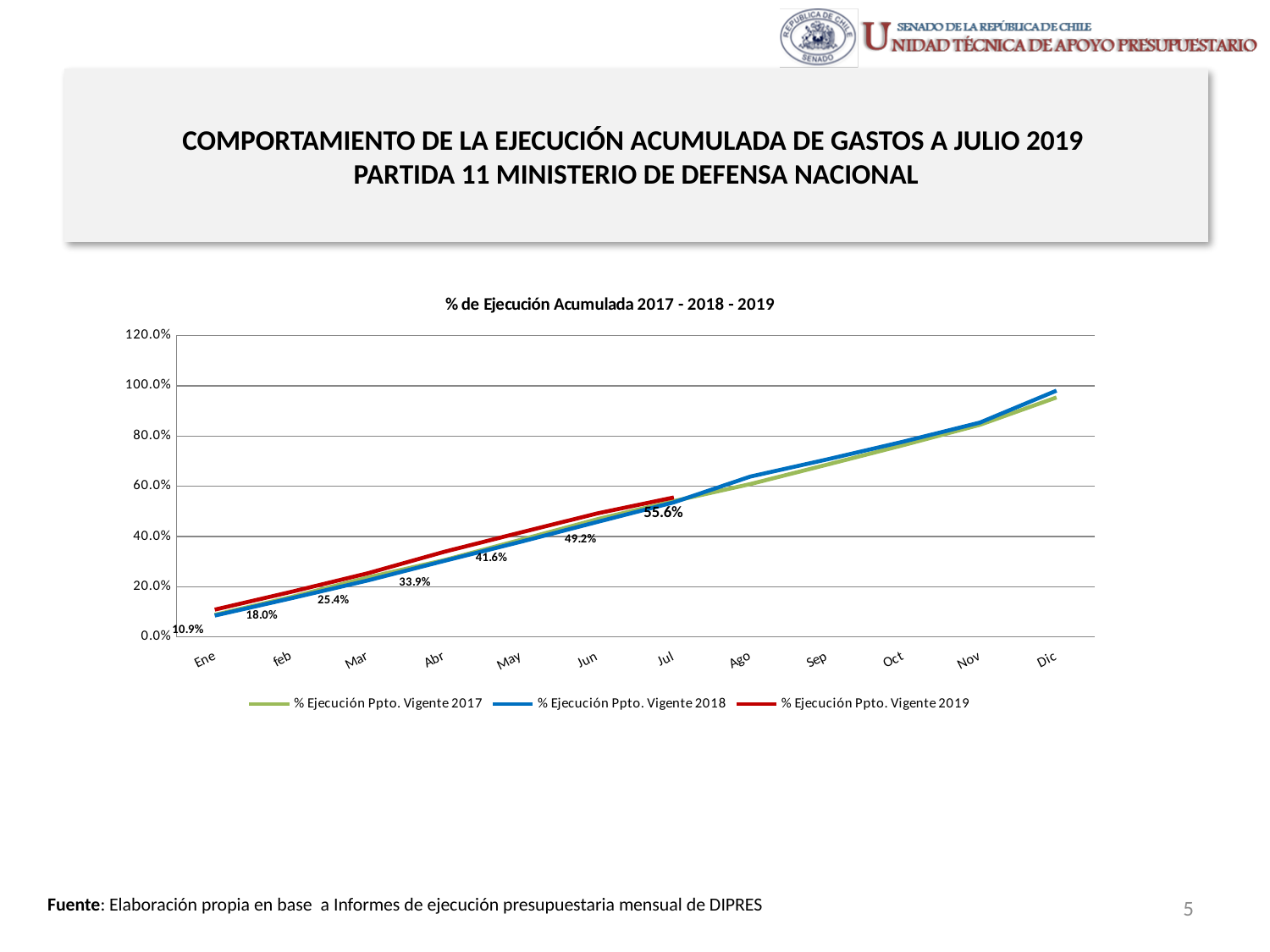
Is the value of % Ejecución Ppto. Vigente 2018 for Dic greater or less than 80.0%? greater What kind of chart is shown on the slide? line chart Which month has the highest labelled value for % Ejecución Ppto. Vigente 2019? Jul What is the value of % Ejecución Ppto. Vigente 2019 for Ene? 10.9% Which month has the lowest labelled value for % Ejecución Ppto. Vigente 2019? Ene What is the value of % Ejecución Ppto. Vigente 2019 for May? 41.6% How many series does the legend list? 3 How many months are shown on the x axis of the chart? 12 What is the value of % Ejecución Ppto. Vigente 2019 for Abr? 33.9% What is the difference between the % Ejecución Ppto. Vigente 2019 values for Mar and feb? 7.4% What is the value of % Ejecución Ppto. Vigente 2019 for Jul? 55.6% What is the difference between the % Ejecución Ppto. Vigente 2019 values for Jul and Jun? 6.4%